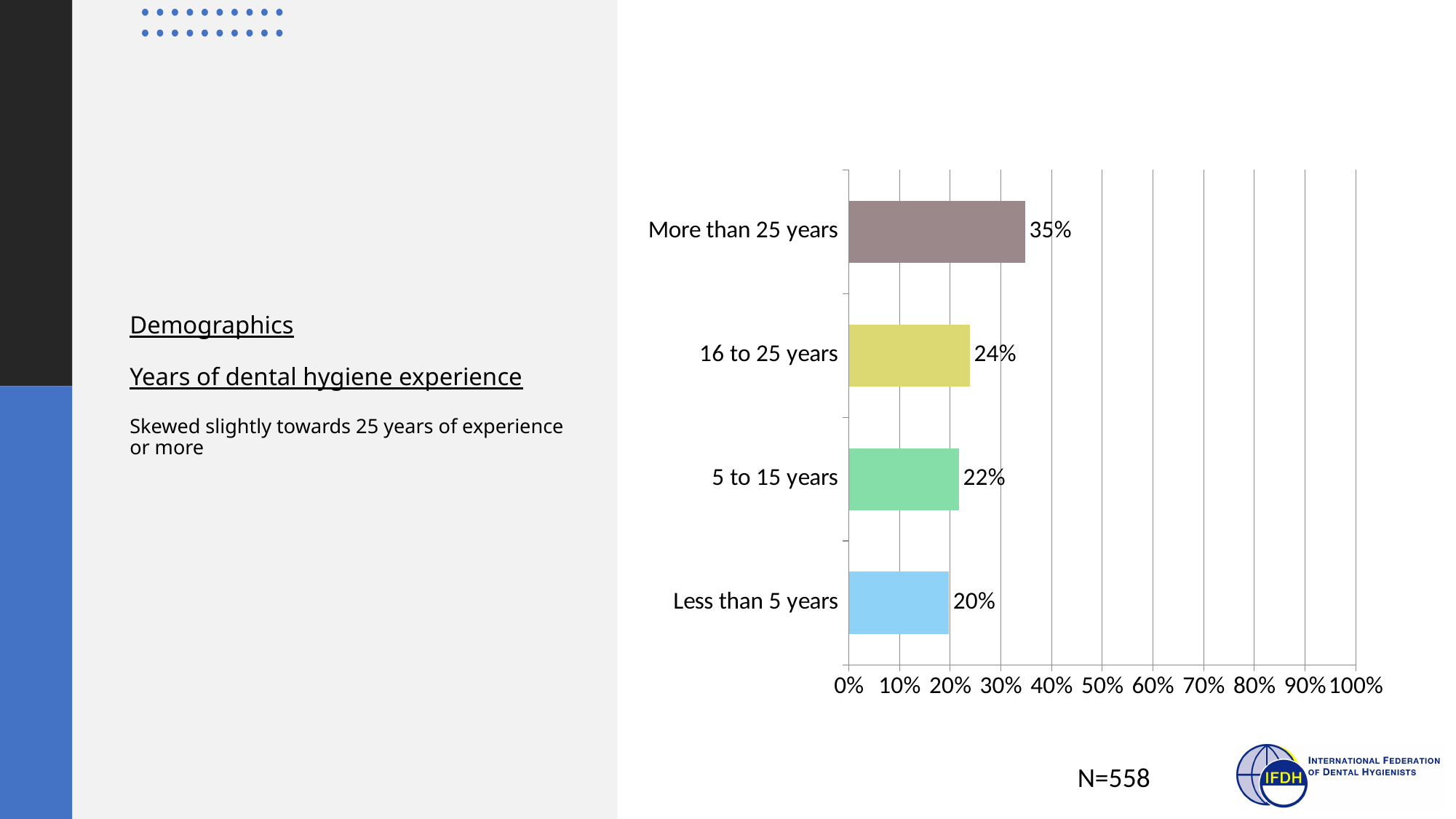
Which experience category has the lowest percentage? Less than 5 years Is the value for 'More than 25 years' greater or less than 30%? greater Which experience category has the highest percentage? More than 25 years How many experience categories are shown in the chart? 4 Which is larger: the percentage for 16 to 25 years or for 5 to 15 years? 16 to 25 years What percentage of respondents have 5 to 15 years of experience? 22% What percentage of respondents have 16 to 25 years of experience? 24% What percentage of respondents have less than 5 years of experience? 20% What percentage of respondents have more than 25 years of dental hygiene experience? 35% What is the sample size (N) shown on the slide? N=558 What is the difference in percentage points between the 'More than 25 years' and 'Less than 5 years' categories? 15 What type of chart is used to show years of dental hygiene experience? Bar chart